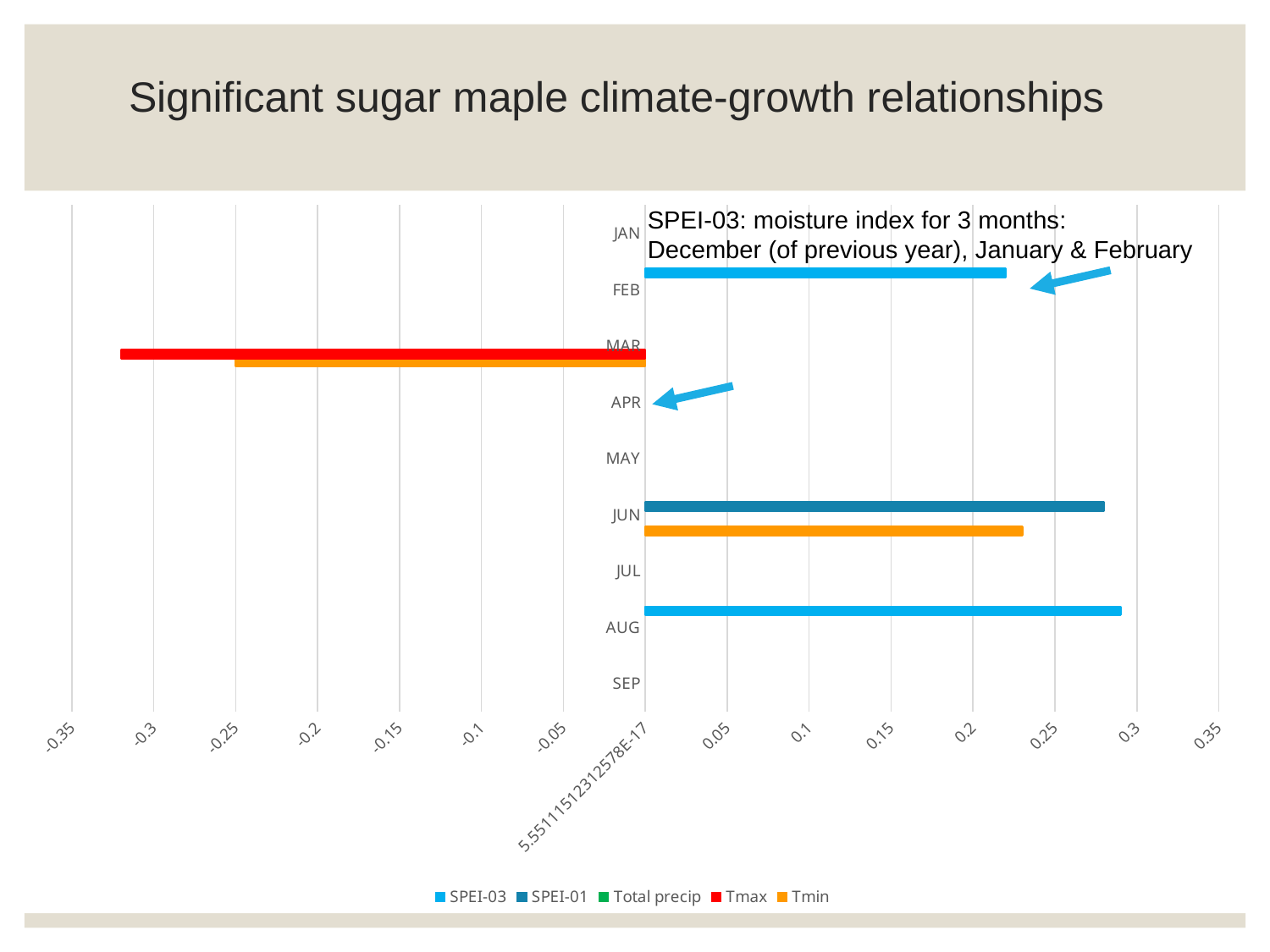
Is the Tmax value for MAR greater or less than -0.3? less In JUN, which series has the larger value, SPEI-01 or Tmin? SPEI-01 Is the SPEI-01 value for JUN greater or less than 0.25? greater How many month categories are shown on the vertical axis? 9 Is the Tmin value for MAR greater or less than -0.2? less Which is larger, the SPEI-03 value for AUG or the SPEI-03 value for FEB? AUG How many series does the legend list? 5 Which series is shown in red in the legend? Tmax What kind of chart is shown on the slide? bar chart